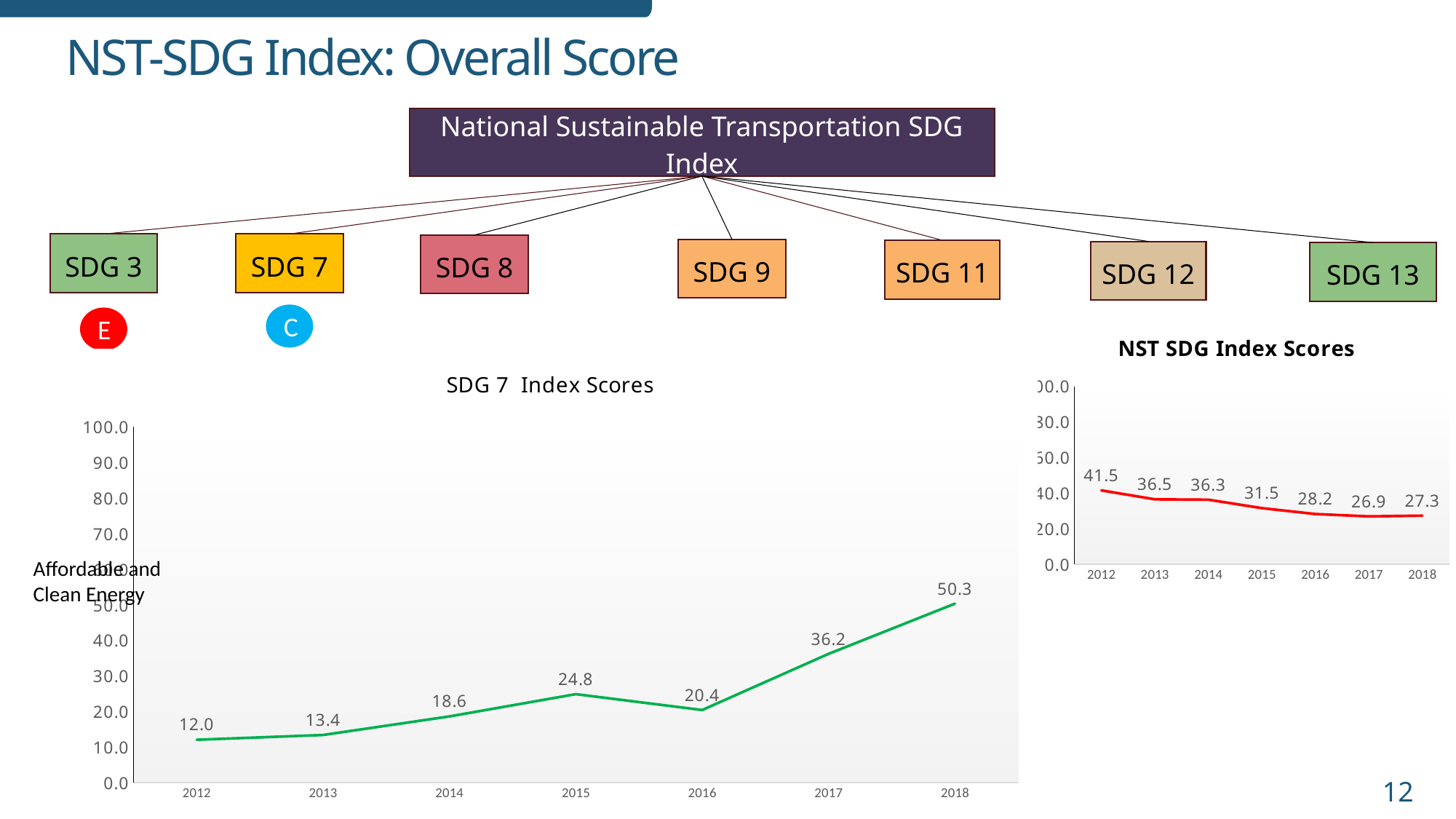
In the SDG 7 Index Scores chart, how many years are plotted? 7 In the NST SDG Index Scores chart, what is the value for 2012? 41.5 What kind of chart is the SDG 7 Index Scores chart? line chart In the SDG 7 Index Scores chart, what is the value for 2018? 50.3 In the NST SDG Index Scores chart, what is the value for 2017? 26.9 In the NST SDG Index Scores chart, what is the difference between the 2012 and 2018 values? 14.2 In the SDG 7 Index Scores chart, which is larger, the value for 2015 or the value for 2016? 2015 In the SDG 7 Index Scores chart, what is the value for 2015? 24.8 In the SDG 7 Index Scores chart, what is the difference between the 2018 and 2017 values? 14.1 In the NST SDG Index Scores chart, which year has the highest value? 2012 In the SDG 7 Index Scores chart, which year has the lowest value? 2012 In the NST SDG Index Scores chart, do the values generally rise or fall from 2012 to 2017? fall